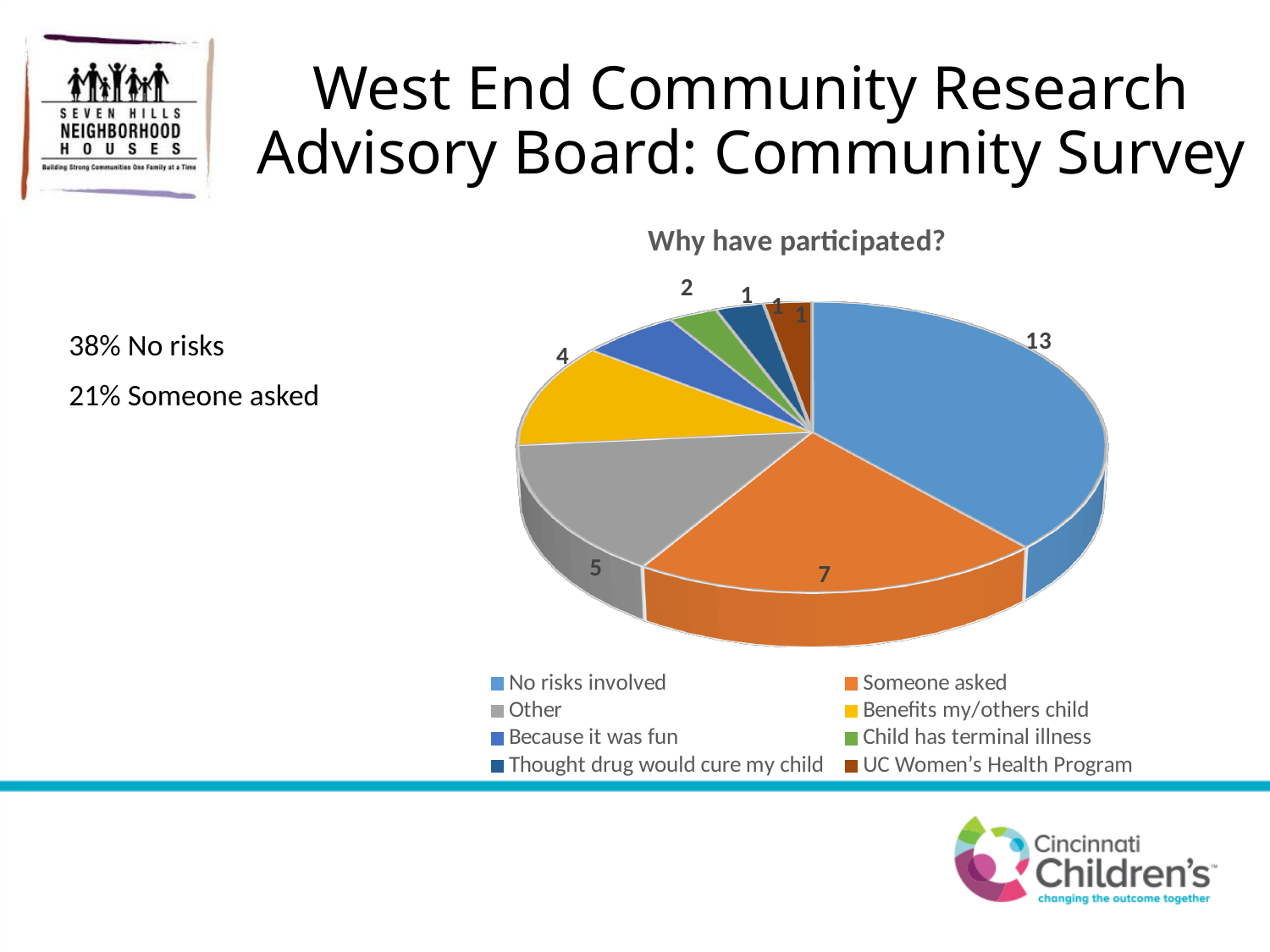
How many categories does the pie chart's legend list? 8 What is the value for "Benefits my/others child" in the pie chart? 4 What is the title of the pie chart? Why have participated? What share of the pie does "No risks involved" represent, according to the slide? 38% What is the value for "No risks involved" in the pie chart? 13 What type of chart is shown on the slide? Pie chart Which category has the largest slice in the pie chart? No risks involved Which is larger in the pie chart: "Other" or "Because it was fun"? Other What is the value for "Someone asked" in the pie chart? 7 What is the difference between the values for "No risks involved" and "Someone asked"? 6 What share of the pie does "Someone asked" represent, according to the slide? 21% What is the value for "Other" in the pie chart? 5